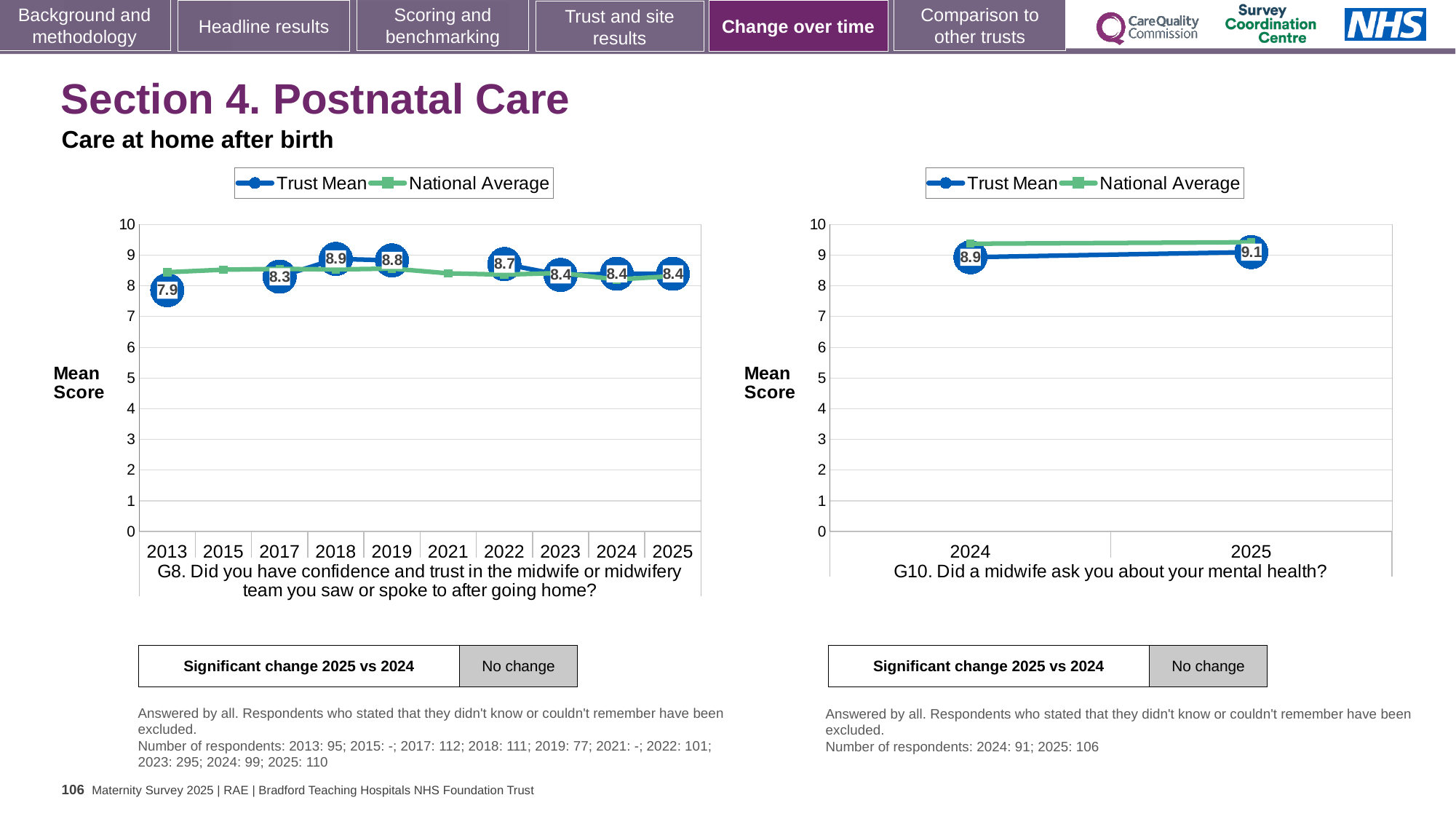
In the G8 chart on the left, what is the Trust Mean for 2018? 8.9 In the G8 chart on the left, which year has the lowest Trust Mean? 2013 In the G8 chart on the left, what is the Trust Mean for 2025? 8.4 In the G10 chart on the right, is the National Average for 2025 greater or less than 9? greater How many series does the legend of the G10 chart on the right list? 2 In the G8 chart on the left, how many years are shown on the x axis? 10 In the G8 chart on the left, what is the Trust Mean for 2013? 7.9 In the G10 chart on the right, did the Trust Mean rise or fall from 2024 to 2025? rise In the G8 chart on the left, which year has the highest Trust Mean? 2018 In the G10 chart on the right, what is the Trust Mean for 2024? 8.9 In the G8 chart on the left, what is the difference between the Trust Mean in 2018 and in 2013? 1.0 In the G10 chart on the right, what is the Trust Mean for 2025? 9.1